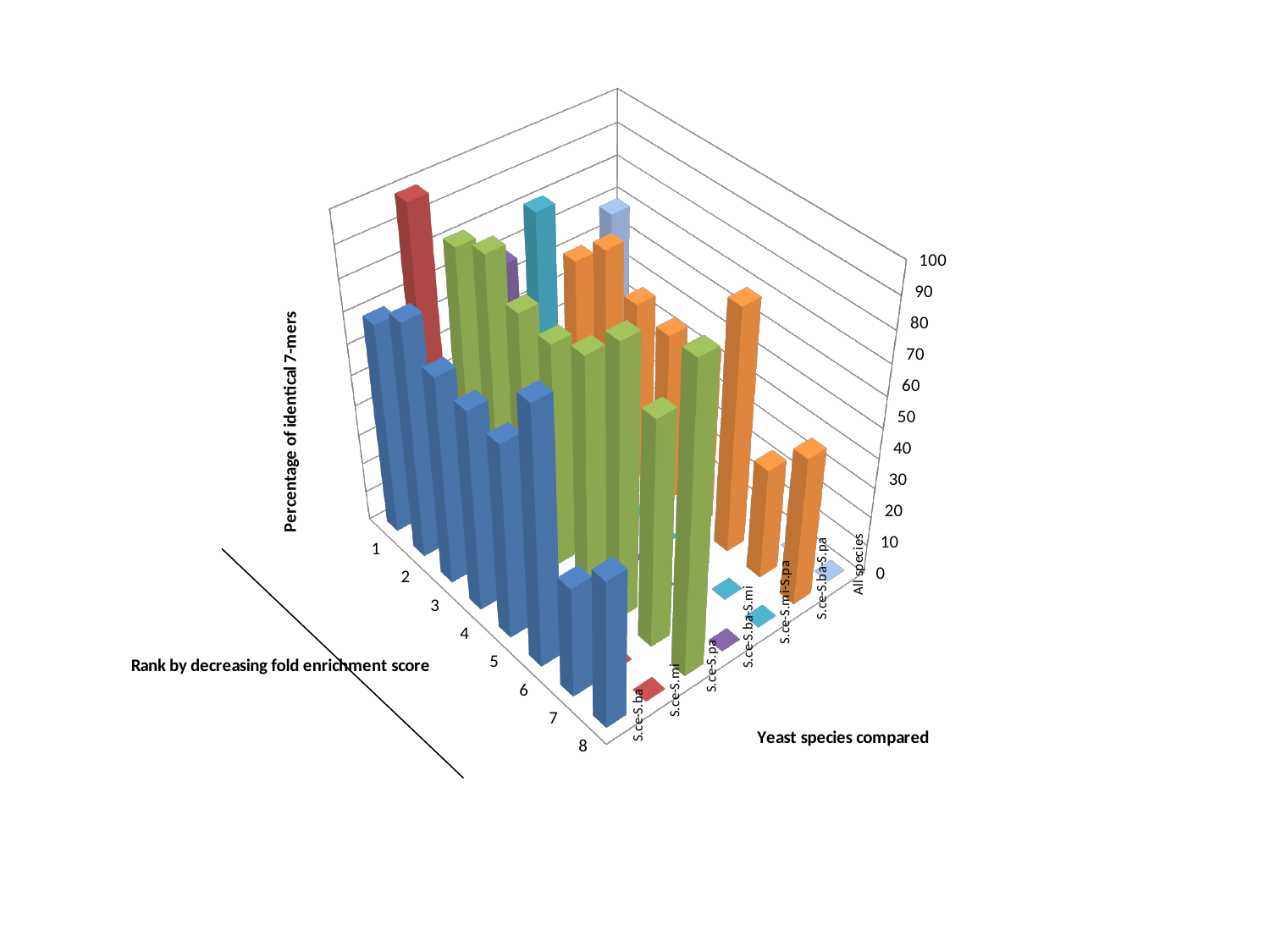
How many rank positions are shown along the 'Rank by decreasing fold enrichment score' axis? 8 How many yeast species comparisons are listed along the 'Yeast species compared' axis? 7 What kind of chart is shown on the slide? 3D bar chart What is the label of the last category on the 'Yeast species compared' axis? All species What is the title of the vertical axis? Percentage of identical 7-mers What is the label of the first category on the 'Yeast species compared' axis? S.ce-S.ba What is the maximum value shown on the vertical axis? 100